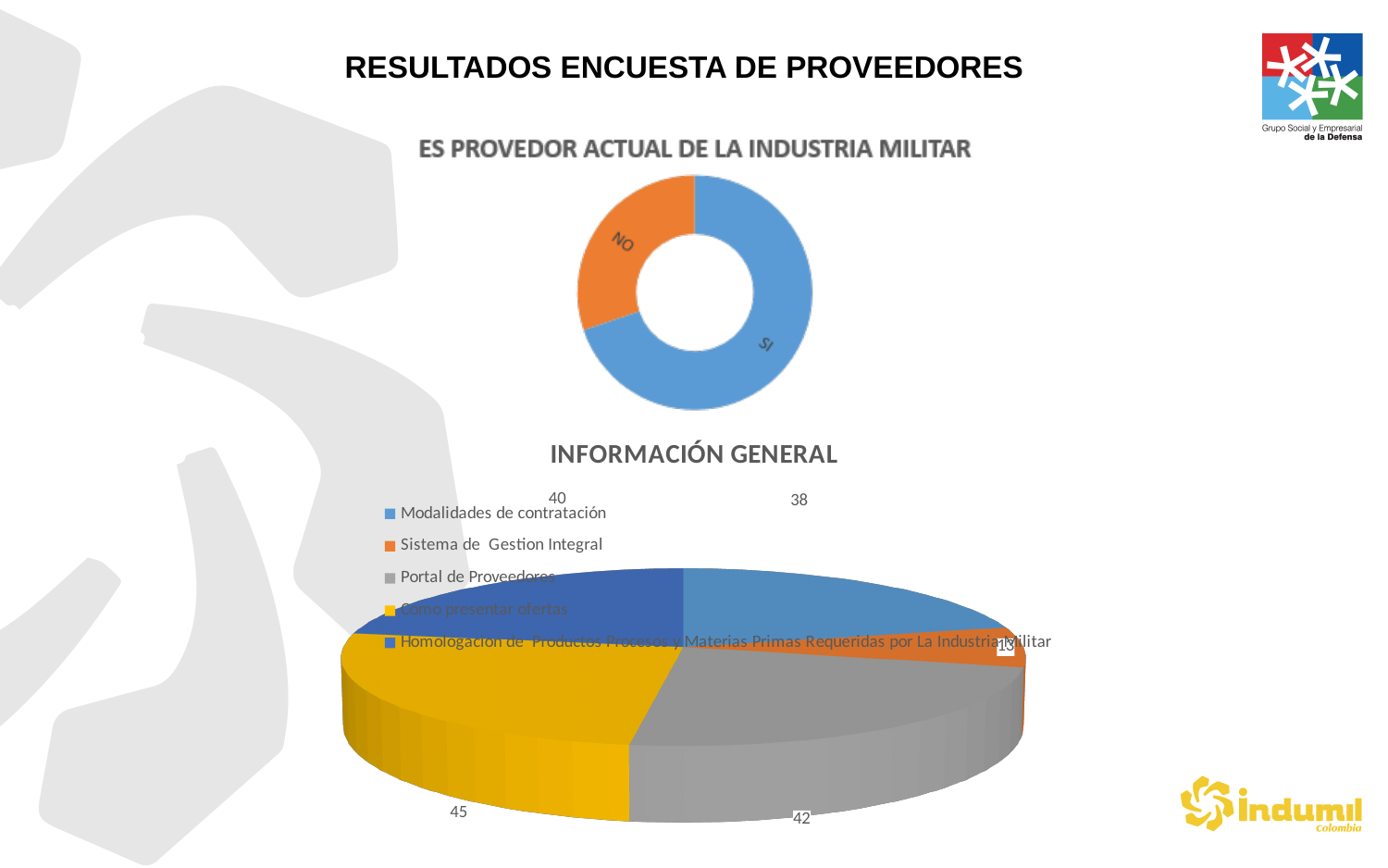
In the 'INFORMACIÓN GENERAL' chart, what is the difference between the values for 'Como presentar ofertas' and 'Sistema de Gestion Integral'? 32 In the 'INFORMACIÓN GENERAL' chart, which category has the lowest value? Sistema de Gestion Integral In the 'ES PROVEDOR ACTUAL DE LA INDUSTRIA MILITAR' chart, which slice is larger, SI or NO? SI In the 'INFORMACIÓN GENERAL' chart, what is the total of all the slice values? 178 How many entries does the legend of the 'INFORMACIÓN GENERAL' chart list? 5 What kind of chart is the 'INFORMACIÓN GENERAL' chart? Pie chart In the 'INFORMACIÓN GENERAL' chart, which category has the highest value? Como presentar ofertas In the 'INFORMACIÓN GENERAL' chart, what is the value for 'Portal de Proveedores'? 42 In the 'INFORMACIÓN GENERAL' chart, what is the value for 'Sistema de Gestion Integral'? 13 In the 'INFORMACIÓN GENERAL' chart, what is the value for 'Como presentar ofertas'? 45 What kind of chart is the 'ES PROVEDOR ACTUAL DE LA INDUSTRIA MILITAR' chart? Doughnut chart How many categories does the 'ES PROVEDOR ACTUAL DE LA INDUSTRIA MILITAR' chart show? 2